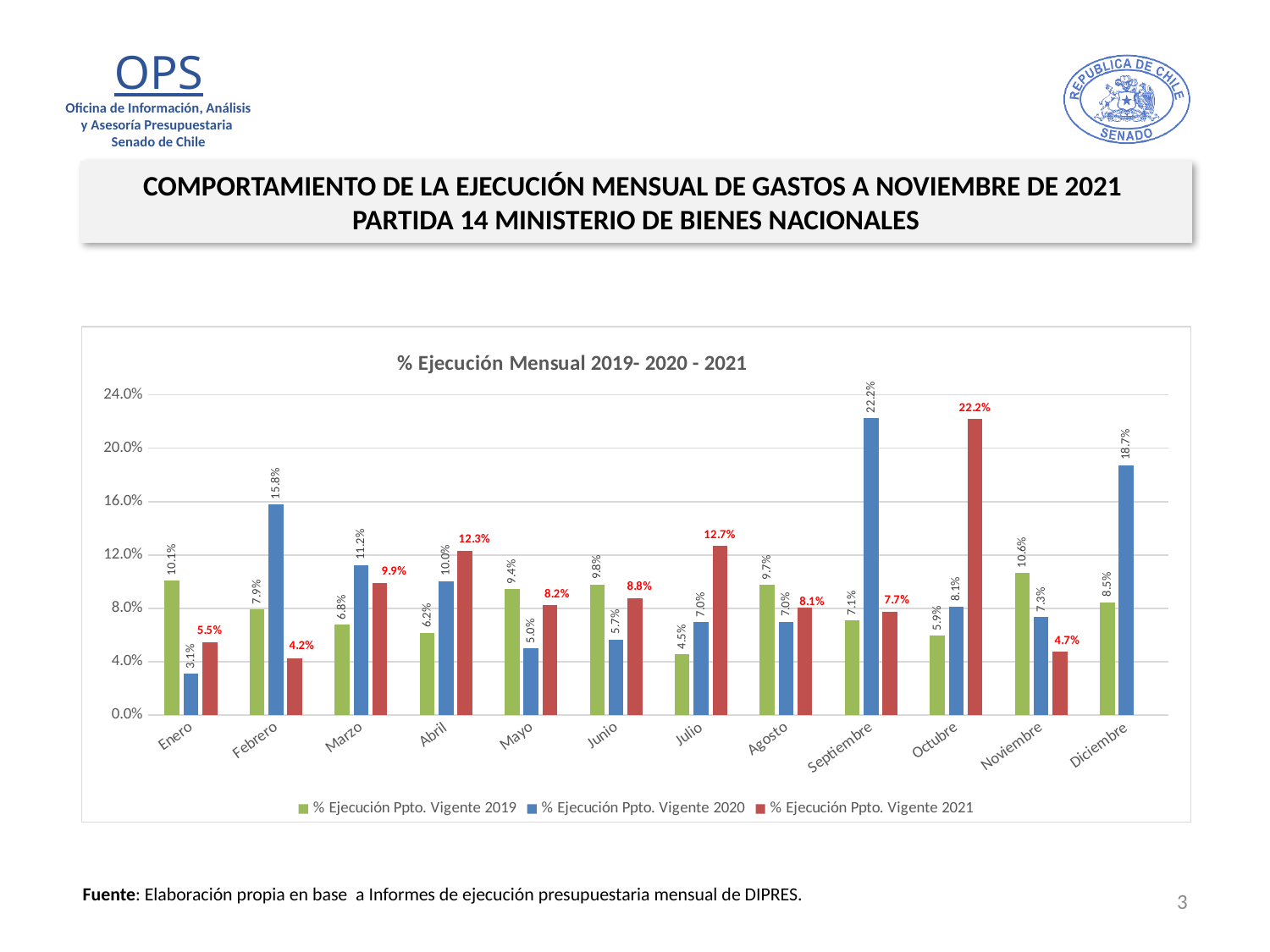
What is the value for % Ejecución Ppto. Vigente 2020 in Febrero? 15.8% What kind of chart is shown on the slide? Bar chart What is the title of the chart? % Ejecución Mensual 2019- 2020 - 2021 How many months are shown on the x axis? 12 Is the value for % Ejecución Ppto. Vigente 2020 in Septiembre greater or less than 20.0%? greater In Julio, which series has the larger value: % Ejecución Ppto. Vigente 2019 or % Ejecución Ppto. Vigente 2021? % Ejecución Ppto. Vigente 2021 What is the value for % Ejecución Ppto. Vigente 2021 in Octubre? 22.2% Which month has the highest value for % Ejecución Ppto. Vigente 2020? Septiembre What is the difference between the 2020 and 2019 values in Diciembre? 10.2% Which month has the lowest value for % Ejecución Ppto. Vigente 2021? Febrero How many series does the legend list? 3 What is the value for % Ejecución Ppto. Vigente 2019 in Noviembre? 10.6%